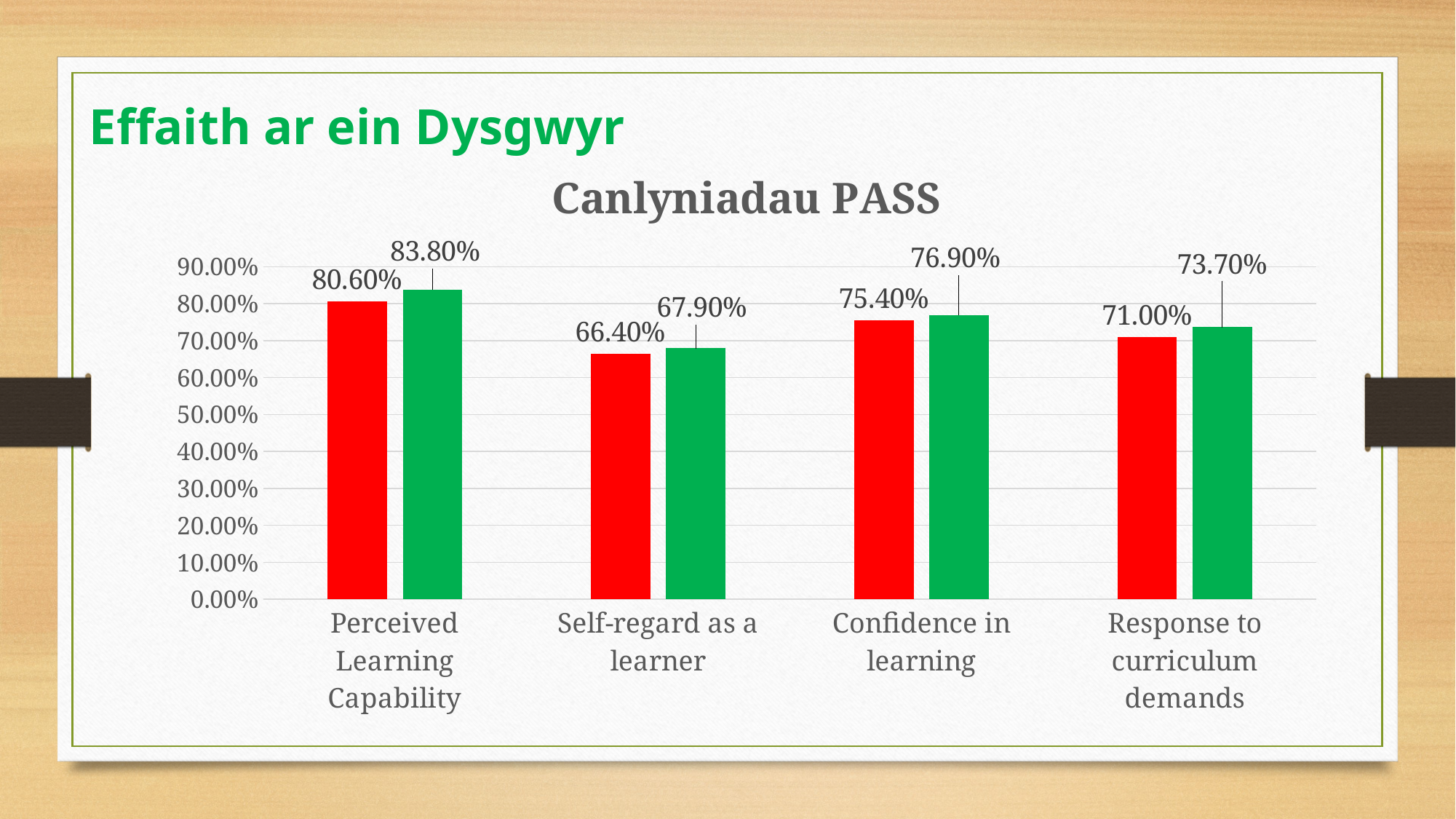
What type of chart is shown on the slide? Bar chart What is the difference between the green and red bar values for Perceived Learning Capability? 3.20% Which category has the highest green bar value? Perceived Learning Capability Which category has the lowest red bar value? Self-regard as a learner What is the difference between the green and red bar values for Response to curriculum demands? 2.70% What is the value of the green bar for Self-regard as a learner? 67.90% Which is larger for Confidence in learning, the red bar or the green bar? The green bar What is the title of the chart? Canlyniadau PASS What is the value of the red bar for Confidence in learning? 75.40% What is the value of the red bar for Perceived Learning Capability? 80.60% How many categories are shown on the x axis? 4 What is the value of the green bar for Response to curriculum demands? 73.70%